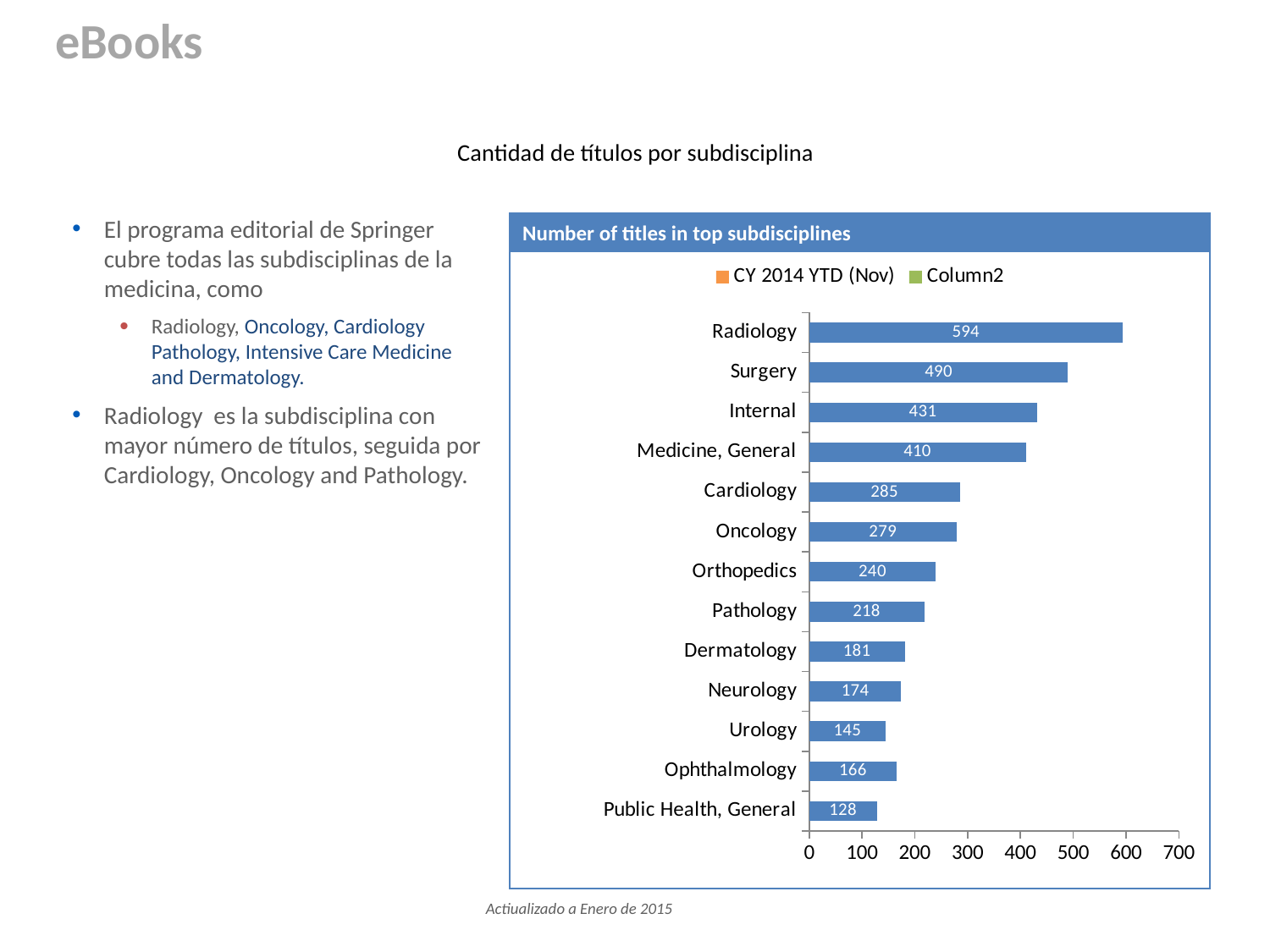
Is the value for Medicine, General greater or less than 400? greater Which subdiscipline has the lowest number of titles? Public Health, General How many subdisciplines are shown in the chart? 13 What is the difference in number of titles between Surgery and Internal? 59 Which has more titles, Urology or Ophthalmology? Ophthalmology What is the difference in number of titles between Cardiology and Oncology? 6 What is the number of titles for Ophthalmology? 166 What is the number of titles for Pathology? 218 How many series does the legend list? 2 What type of chart is shown on the slide? Bar chart What is the number of titles for Radiology? 594 Which subdiscipline has the highest number of titles? Radiology